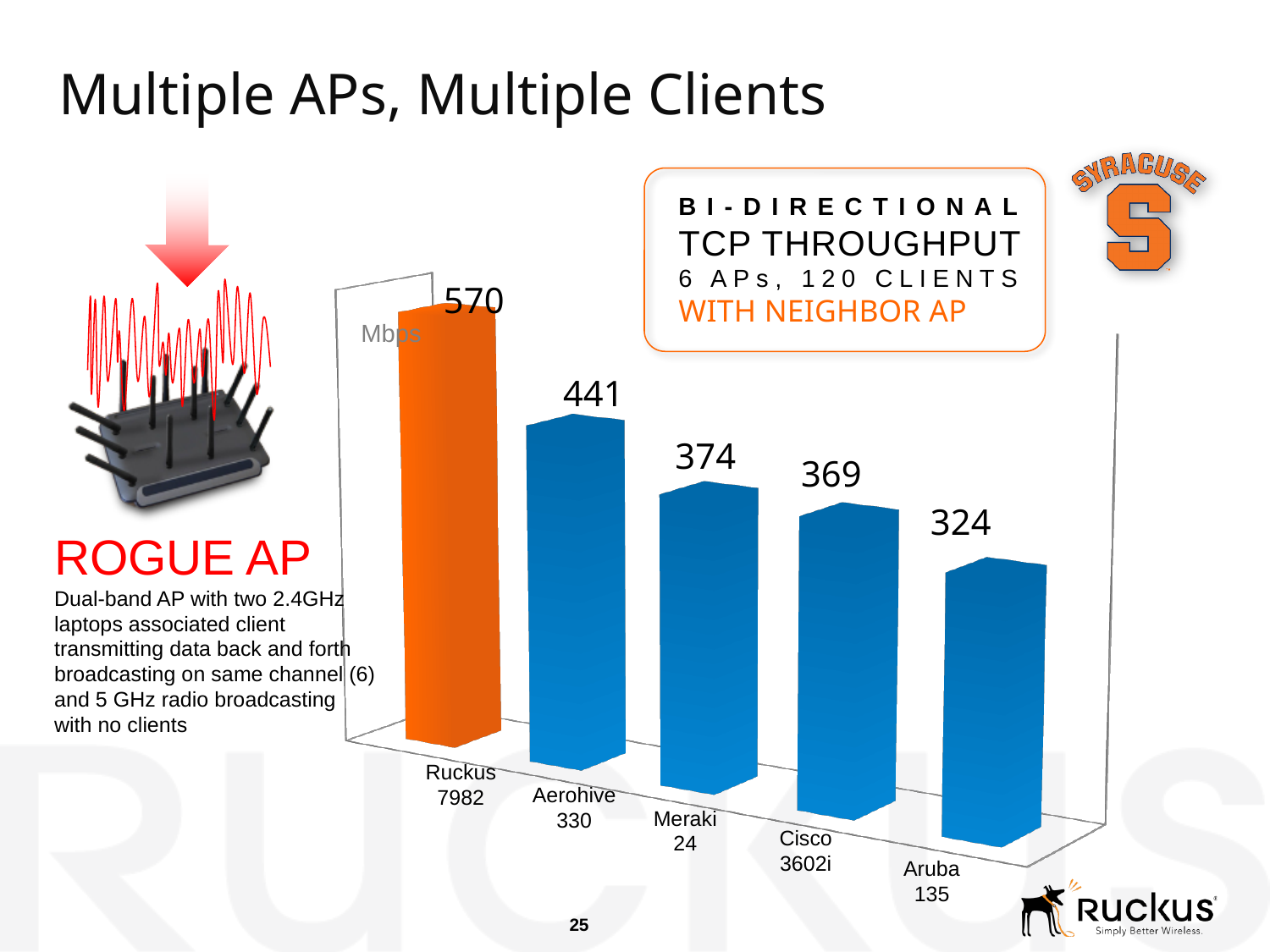
Which access point has the lowest throughput in the chart? Aruba 135 What is the throughput value shown for Ruckus 7982? 570 What is the throughput value shown for Aerohive 330? 441 Which access point has the highest throughput in the chart? Ruckus 7982 How many access points are compared in the chart? 5 What is the throughput value shown for Aruba 135? 324 What is the throughput value shown for Cisco 3602i? 369 What type of chart is shown on the slide? Bar chart What is the throughput value shown for Meraki 24? 374 What is the difference in throughput between Meraki 24 and Aruba 135? 50 What is the difference in throughput between Ruckus 7982 and Aerohive 330? 129 Which has a higher throughput, Aerohive 330 or Cisco 3602i? Aerohive 330